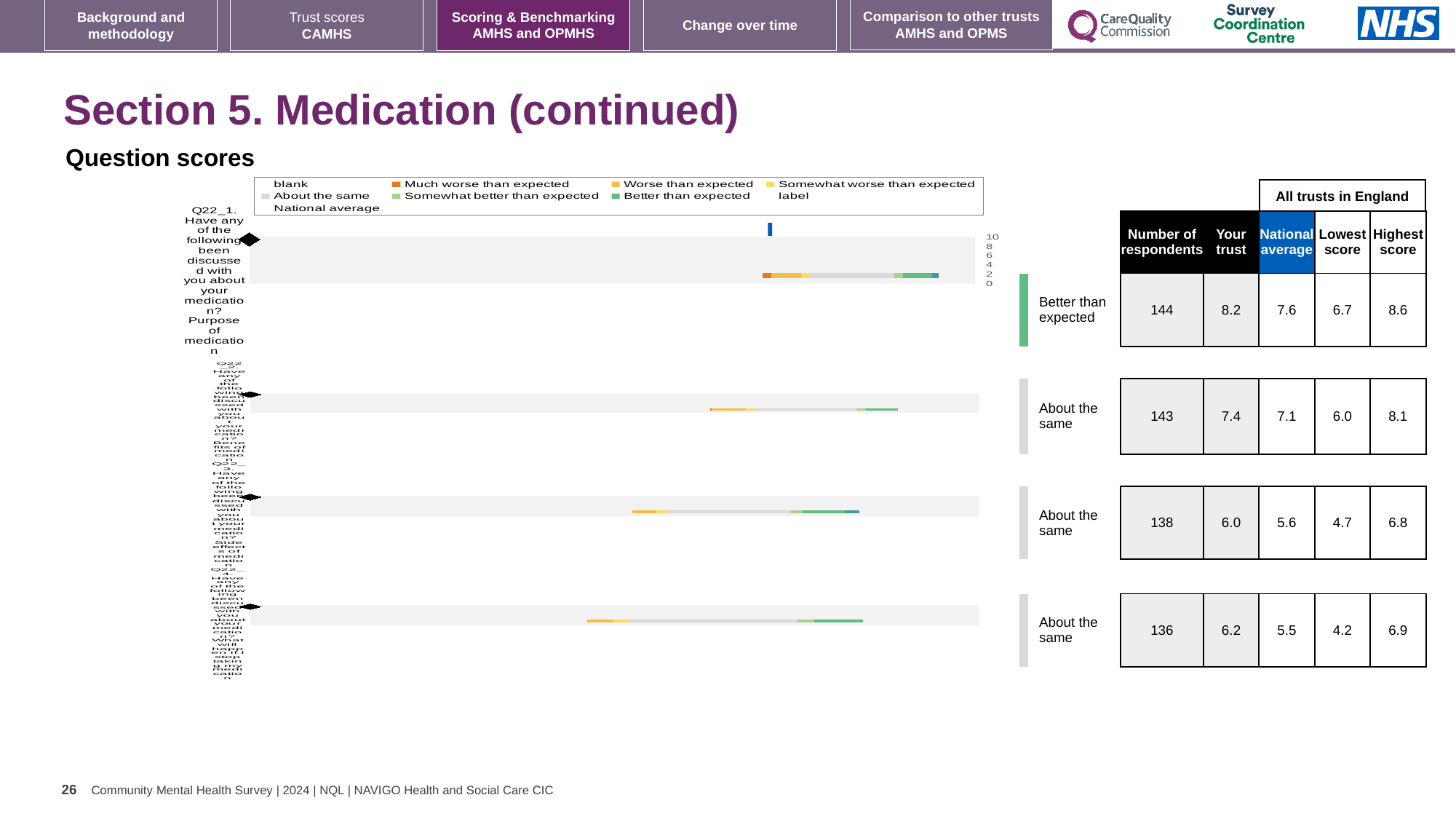
In the legend above the charts, which colour represents 'Much worse than expected'? orange What benchmark category is written beside the first bar chart (Q22_1, Purpose of medication)? Better than expected What benchmark category is written beside the fourth (bottom) bar chart? About the same What benchmark category is written beside the second bar chart? About the same What is the highest tick value shown on the axis of the first bar chart? 10 How many separate bar charts are shown under 'Question scores'? 4 What kind of chart is used to show the question scores on this slide? bar chart In the legend above the charts, which colour represents 'Better than expected'? green